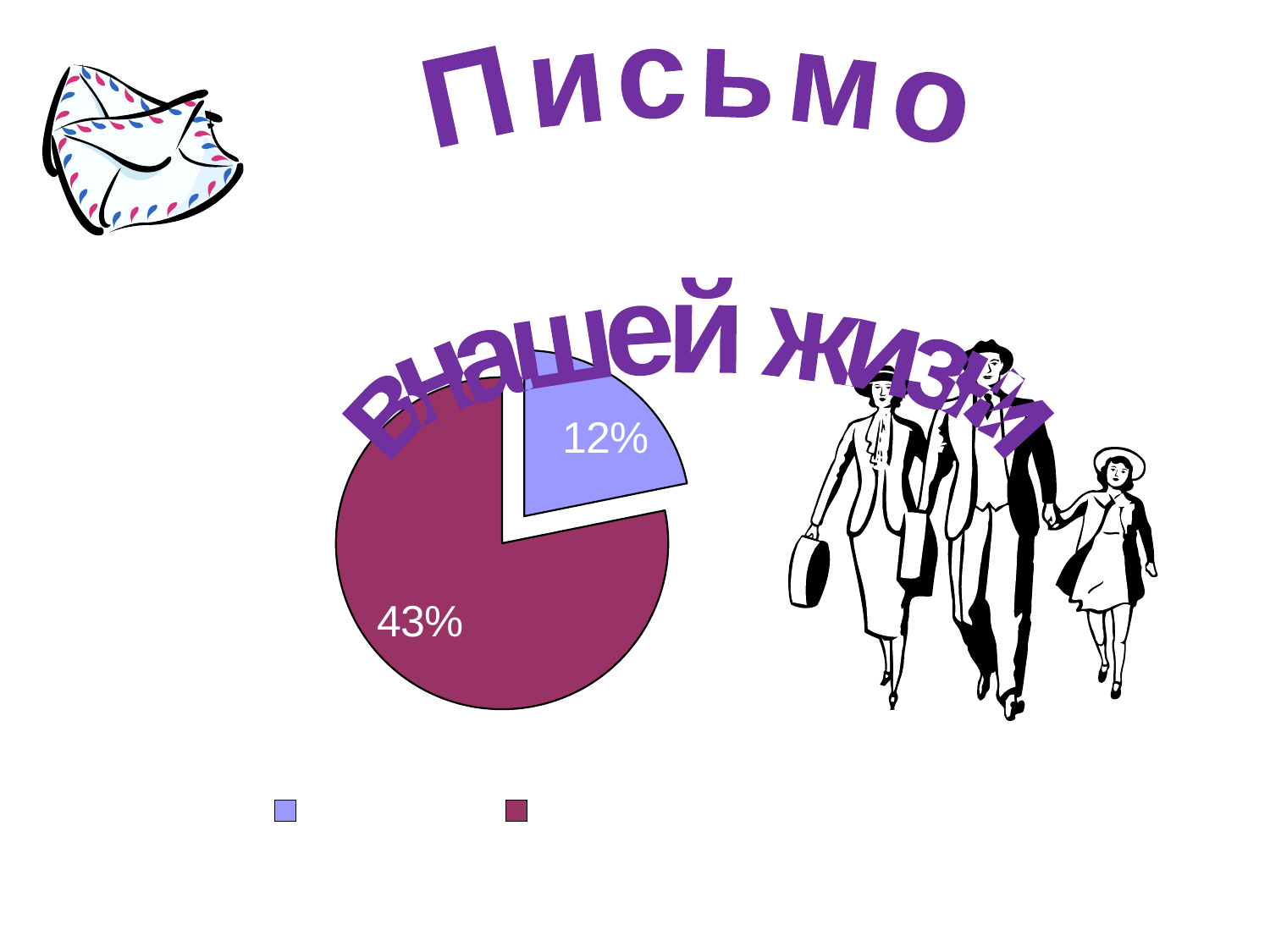
Which slice of the pie chart is pulled out (exploded) from the rest of the pie? the light blue slice (12%) Which is larger in the pie chart: the light blue slice or the dark magenta slice? the dark magenta slice What value is printed on the dark magenta slice of the pie chart? 43% Which slice of the pie chart is the smallest? the light blue slice (12%) What is the difference between the values printed on the dark magenta slice and the light blue slice? 31 percentage points What colour is the slice labelled 43%? dark magenta What share is labelled on the light blue slice of the pie chart? 12% How many entries does the legend below the pie chart show? 2 How many slices does the pie chart have? 2 What kind of chart is shown on the slide? pie chart Which slice of the pie chart is the largest? the dark magenta slice (43%) What value is printed on the light blue slice of the pie chart? 12%